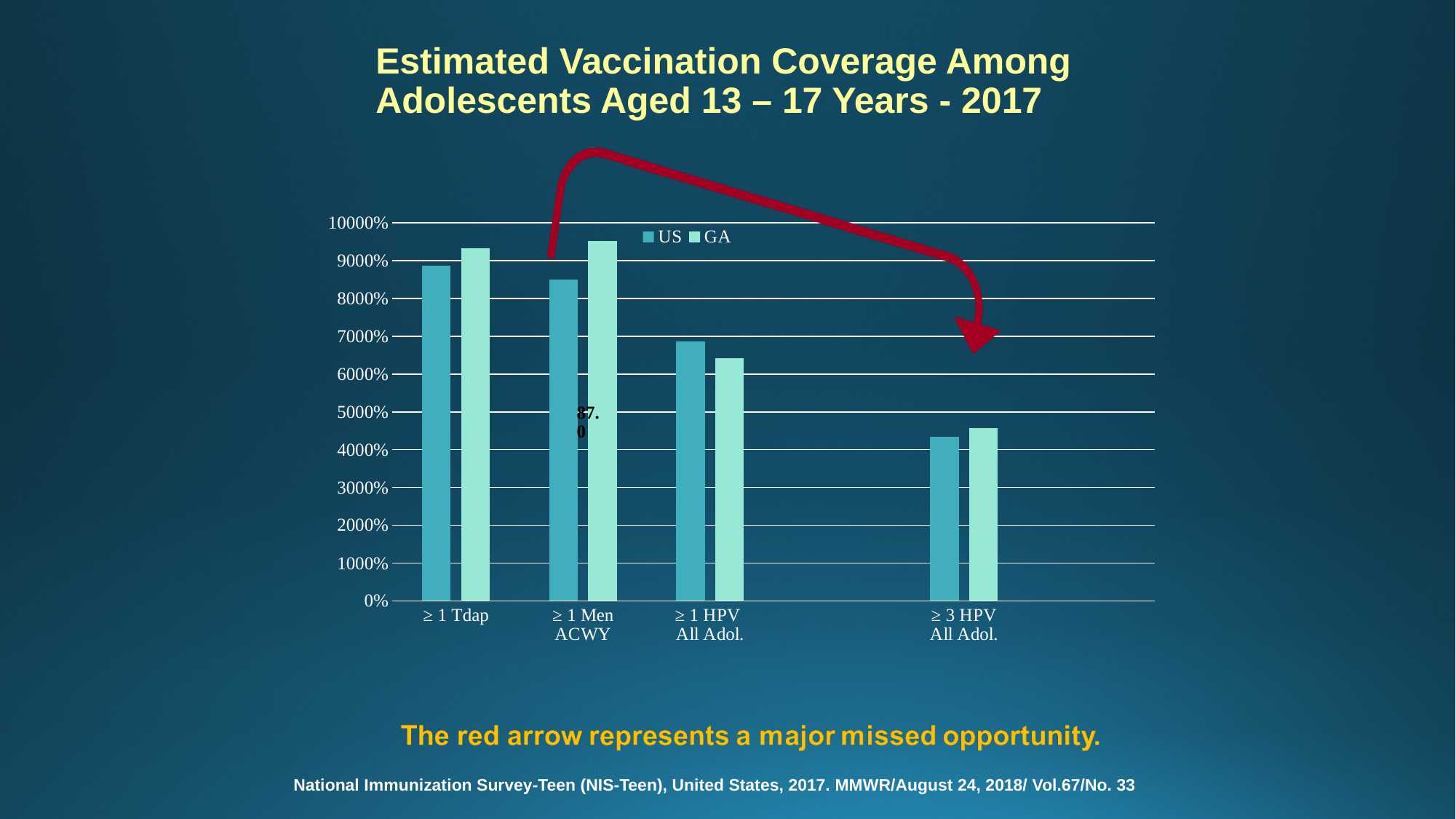
Is the GA value for ≥ 1 HPV All Adol. greater or less than 7000%? less Which category has the lowest US bar? ≥ 3 HPV All Adol. What are the two series named in the legend? US and GA How many series does the legend list? 2 How many vaccine categories are shown on the x axis? 4 For ≥ 1 Tdap, which is larger, the US bar or the GA bar? GA What kind of chart is shown on the slide? bar chart Is the US value for ≥ 3 HPV All Adol. greater or less than 5000%? less Which category has the highest GA bar? ≥ 1 Men ACWY Do the US values generally rise or fall moving from ≥ 1 Tdap to ≥ 3 HPV All Adol. along the x axis? fall For ≥ 1 HPV All Adol., which is larger, the US bar or the GA bar? US Is the GA value for ≥ 1 Men ACWY greater or less than 9000%? greater